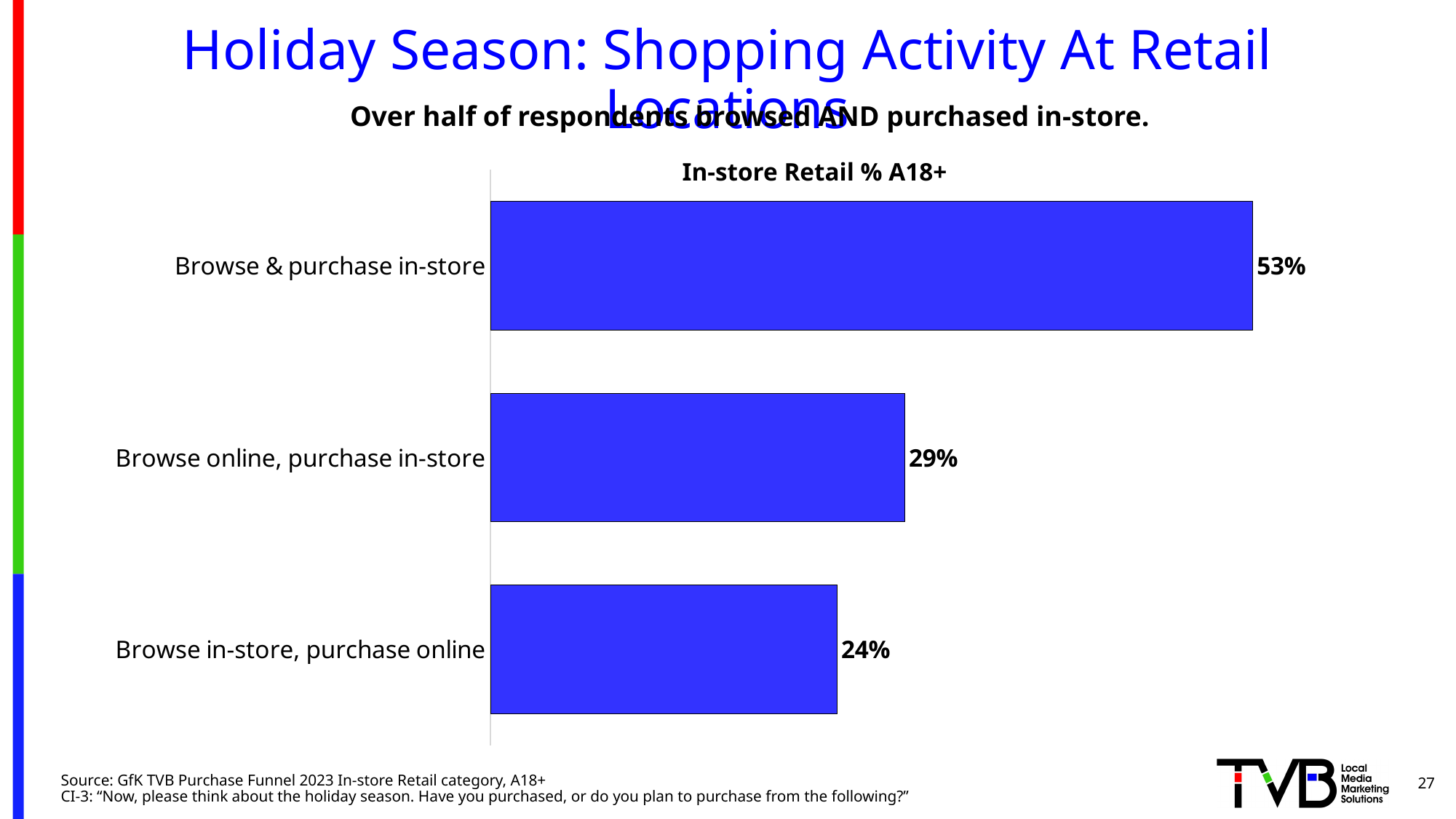
Which is larger: 'Browse online, purchase in-store' or 'Browse in-store, purchase online'? Browse online, purchase in-store What percentage of respondents browse & purchase in-store? 53% What is the value for 'Browse online, purchase in-store'? 29% Which category has the highest value? Browse & purchase in-store What kind of chart is shown on the slide? Bar chart What colour are the bars in the chart? Blue Which category has the lowest value? Browse in-store, purchase online How many categories are shown in the chart? 3 What is the difference between 'Browse online, purchase in-store' and 'Browse in-store, purchase online'? 5% What is the value for 'Browse in-store, purchase online'? 24% What is the title of the chart? In-store Retail % A18+ What is the difference between 'Browse & purchase in-store' and 'Browse online, purchase in-store'? 24%